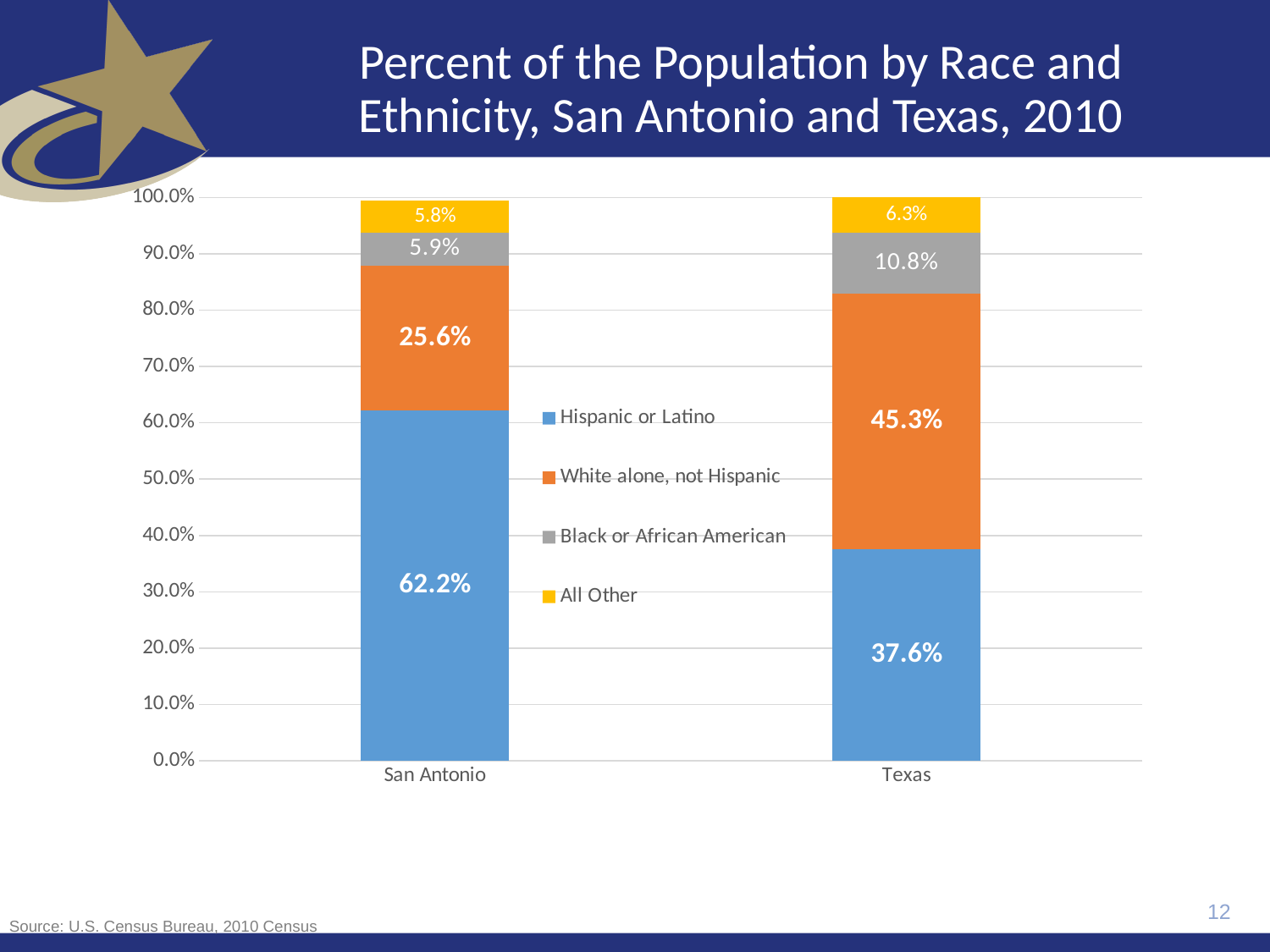
What is the Black or African American share of the population in Texas? 10.8% Which is larger: the Black or African American share in San Antonio or in Texas? Texas Which group has the smallest share of the population in San Antonio? All Other What is the All Other share of the population in San Antonio? 5.8% Which group has the largest share of the population in Texas? White alone, not Hispanic What kind of chart is shown on the slide? Stacked bar chart How many categories are shown on the x axis? 2 What is the White alone, not Hispanic share of the population in Texas? 45.3% What is the Hispanic or Latino share of the population in San Antonio? 62.2% What is the total of the labelled segments in the Texas bar? 100.0% What is the difference between the Hispanic or Latino share in San Antonio and in Texas? 24.6% How many series does the legend list? 4